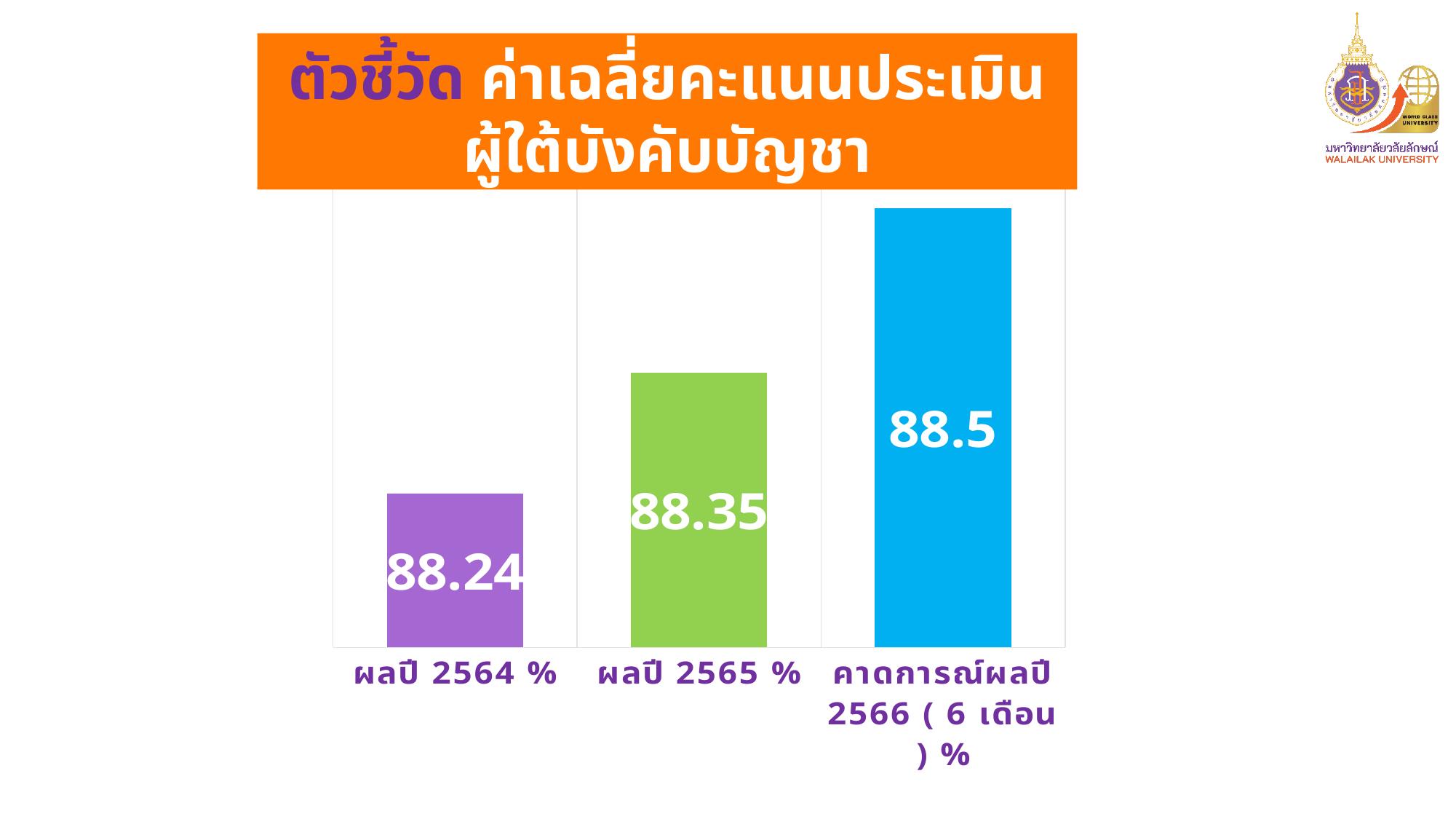
How many categories are shown in the chart? 3 What is the value for ผลปี 2565 %? 88.35 What is the difference between the values for คาดการณ์ผลปี 2566 ( 6 เดือน ) % and ผลปี 2565 %? 0.15 What colour is the bar for คาดการณ์ผลปี 2566 ( 6 เดือน ) %? Blue Which is larger, the value for ผลปี 2564 % or the value for ผลปี 2565 %? ผลปี 2565 % Do the values rise or fall from left to right across the categories? Rise Which category has the highest value? คาดการณ์ผลปี 2566 ( 6 เดือน ) % What kind of chart is shown on the slide? Bar chart What is the value for ผลปี 2564 %? 88.24 Which category has the lowest value? ผลปี 2564 % What is the value for คาดการณ์ผลปี 2566 ( 6 เดือน ) %? 88.5 What is the difference between the values for ผลปี 2565 % and ผลปี 2564 %? 0.11